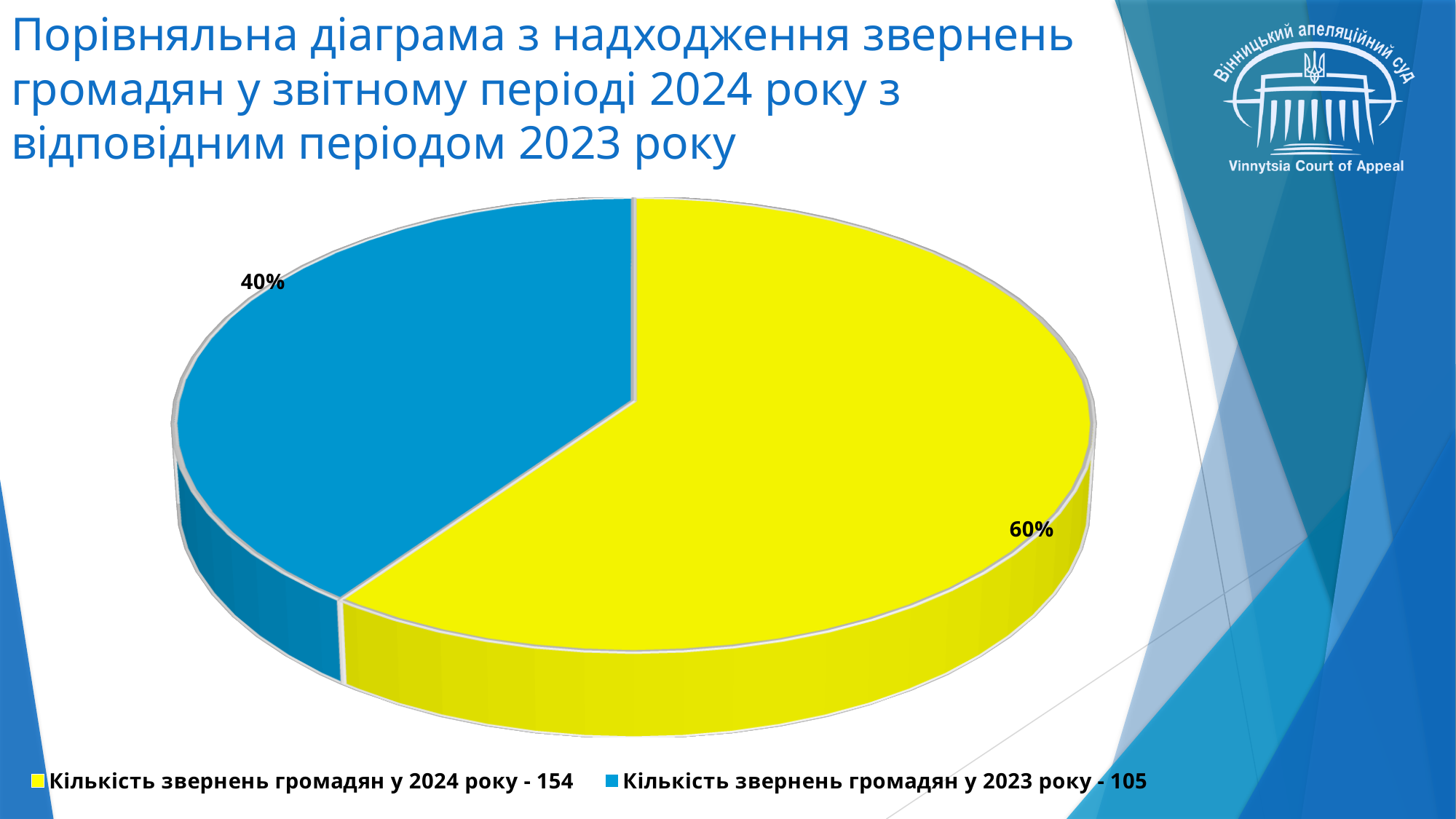
What is the total number of appeals across both years shown in the legend? 259 What kind of chart is shown on the slide? pie chart Which year has the larger share of the pie, 2024 or 2023? 2024 How many entries does the legend list? 2 Which slice is the smallest in the pie chart? Кількість звернень громадян у 2023 року - 105 What is the difference between the number of appeals in 2024 and in 2023, as given in the legend? 49 According to the legend, how many citizen appeals were received in 2024? 154 What percentage is shown for the yellow slice (Кількість звернень громадян у 2024 року)? 60% What colour is the slice representing 2023? blue How many slices does the pie chart have? 2 What percentage is shown for the blue slice (Кількість звернень громадян у 2023 року)? 40% According to the legend, how many citizen appeals were received in 2023? 105